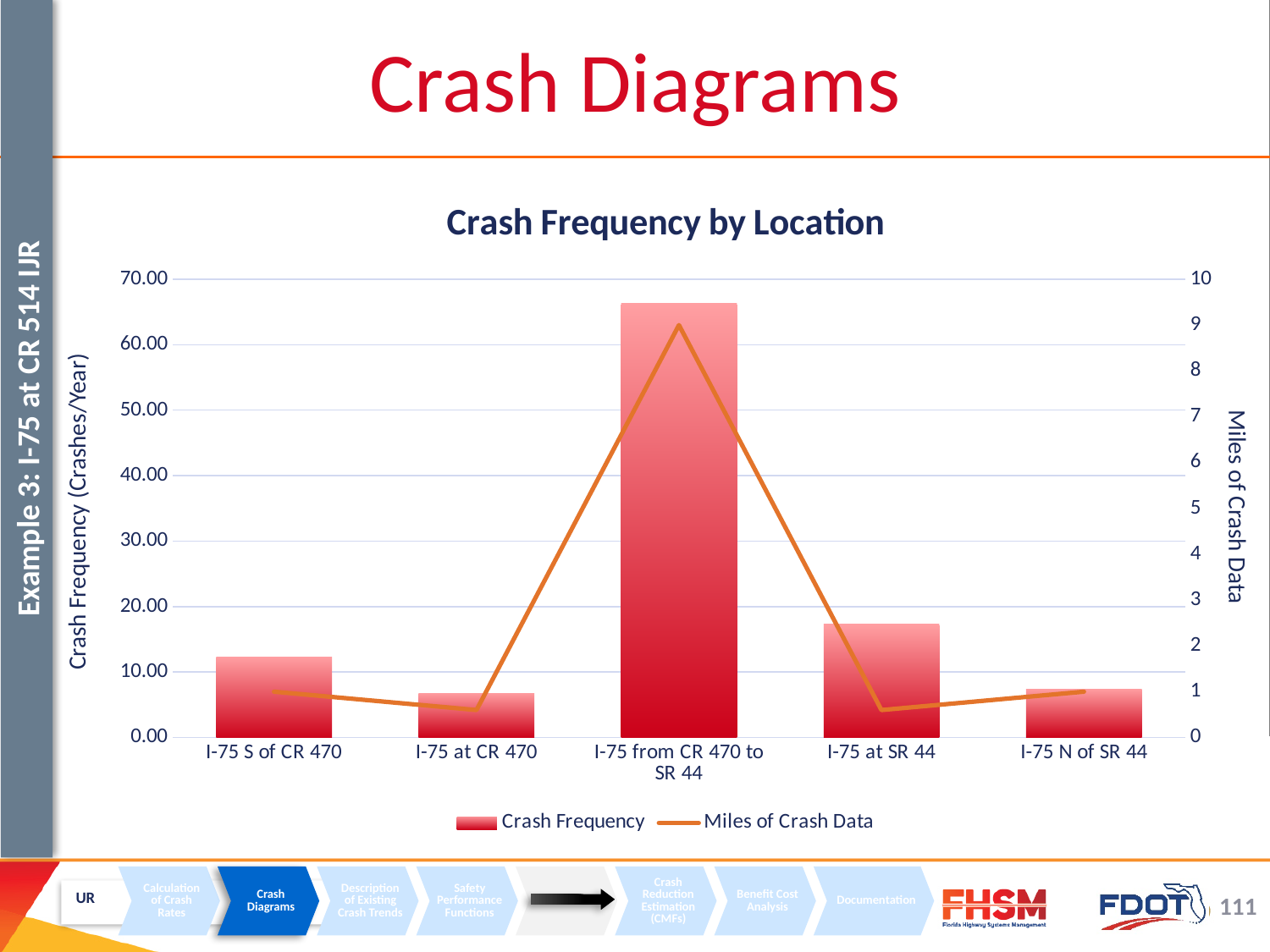
How many series does the chart's legend list? 2 What is the title of the chart? Crash Frequency by Location Which has the larger Crash Frequency, I-75 S of CR 470 or I-75 at SR 44? I-75 at SR 44 Which series is drawn as a line in the chart? Miles of Crash Data Which location has the highest Crash Frequency? I-75 from CR 470 to SR 44 Which location has the highest Miles of Crash Data? I-75 from CR 470 to SR 44 Is the Crash Frequency for I-75 S of CR 470 greater or less than 10.00? greater What kind of chart is used for the Crash Frequency series? Bar chart Is the Miles of Crash Data value for I-75 from CR 470 to SR 44 greater or less than 8? greater Is the Crash Frequency for I-75 from CR 470 to SR 44 greater or less than 60.00? greater How many locations are shown on the x axis of the chart? 5